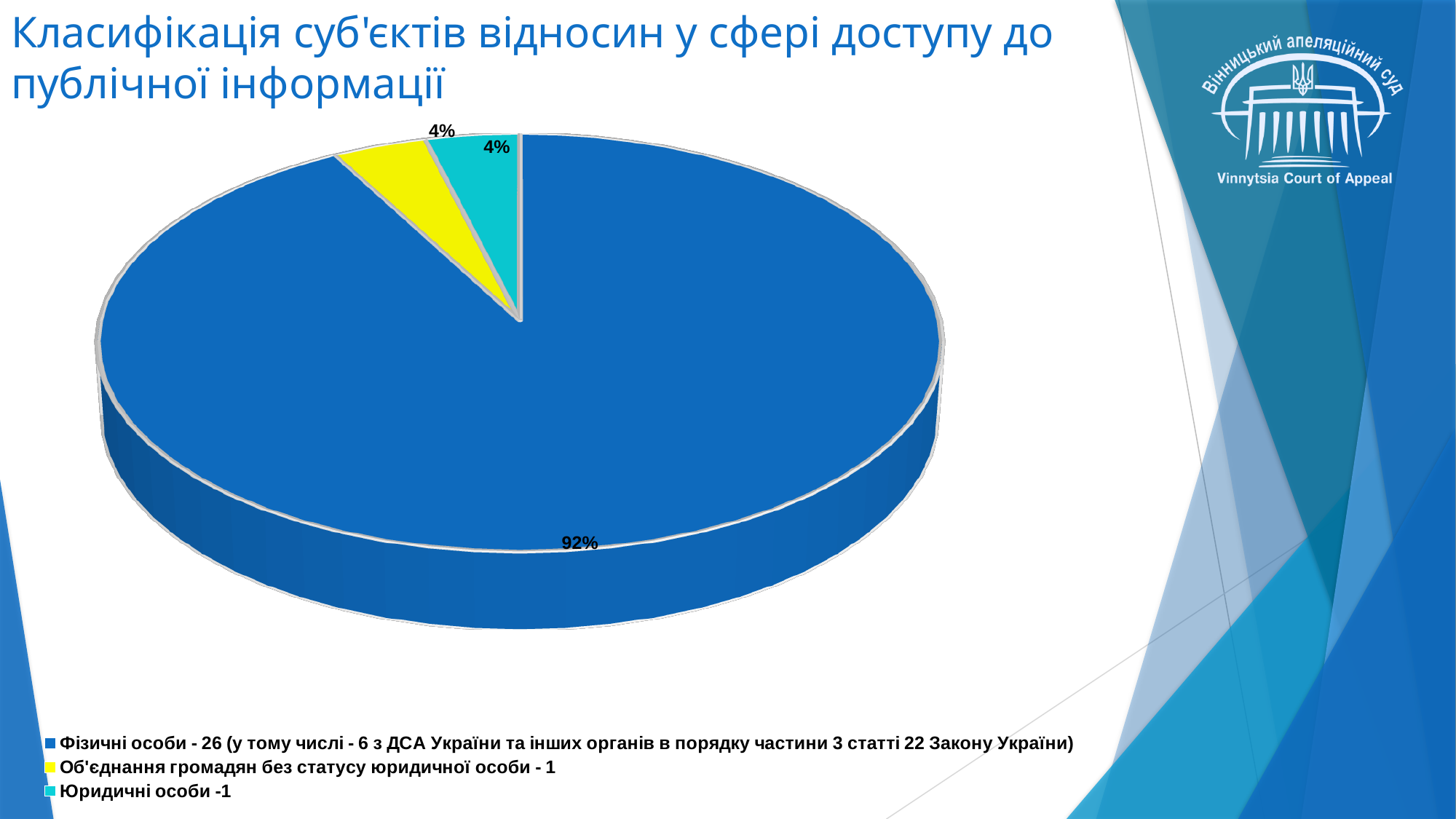
What colour is the slice for "Об'єднання громадян без статусу юридичної особи"? Yellow According to the legend, how many "Фізичні особи" are there? 26 What is the difference in percentage points between the share for "Фізичні особи" and the share for "Юридичні особи"? 88 percentage points Which category has the largest slice of the pie? Фізичні особи How many slices does the pie chart have? 3 What percentage share does the slice for "Об'єднання громадян без статусу юридичної особи" have? 4% What type of chart is shown on the slide? Pie chart What percentage share does the slice for "Фізичні особи" have? 92% Which is larger: the share for "Фізичні особи" or the share for "Об'єднання громадян без статусу юридичної особи"? Фізичні особи What percentage share does the slice for "Юридичні особи" have? 4% How many entries does the legend list? 3 According to the legend, how many "Юридичні особи" are there? 1